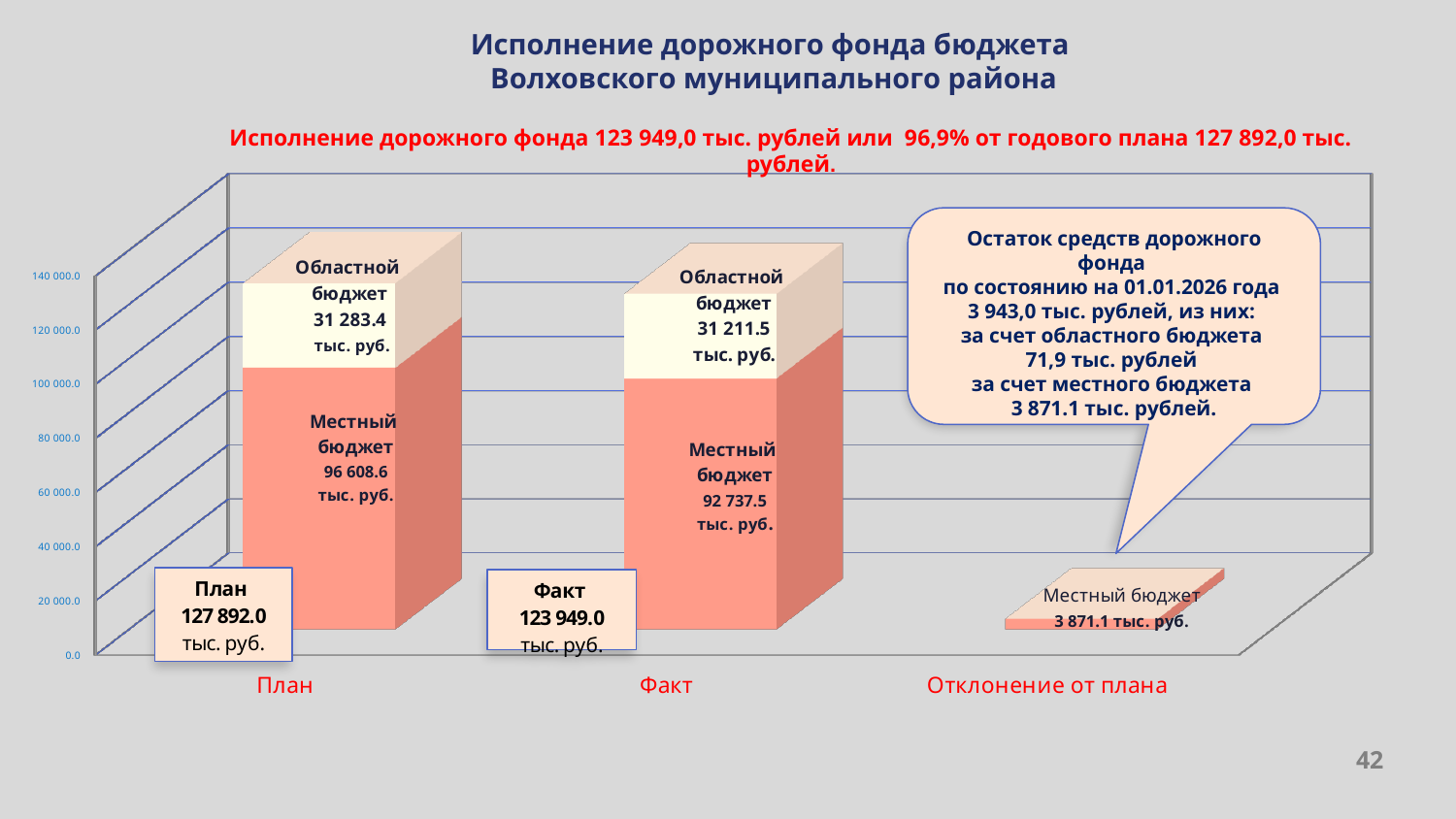
What is the value shown for Местный бюджет in the Отклонение от плана category? 3 871.1 тыс. руб. What is the total of the План bar? 127 892.0 тыс. руб. What is the value of the Областной бюджет segment for the Факт bar? 31 211.5 тыс. руб. What is the total of the Факт bar? 123 949.0 тыс. руб. Which is larger, the Областной бюджет value for План or for Факт? План What kind of chart is shown on the slide? Stacked bar chart Is the Местный бюджет value for Факт greater or less than 80 000.0? greater What is the difference between the Областной бюджет values for План and Факт? 71.9 тыс. руб. What is the value of the Местный бюджет segment for the План bar? 96 608.6 тыс. руб. What is the difference between the Местный бюджет values for План and Факт? 3 871.1 тыс. руб. How many categories are shown on the x axis? 3 Which category has the lowest total value? Отклонение от плана